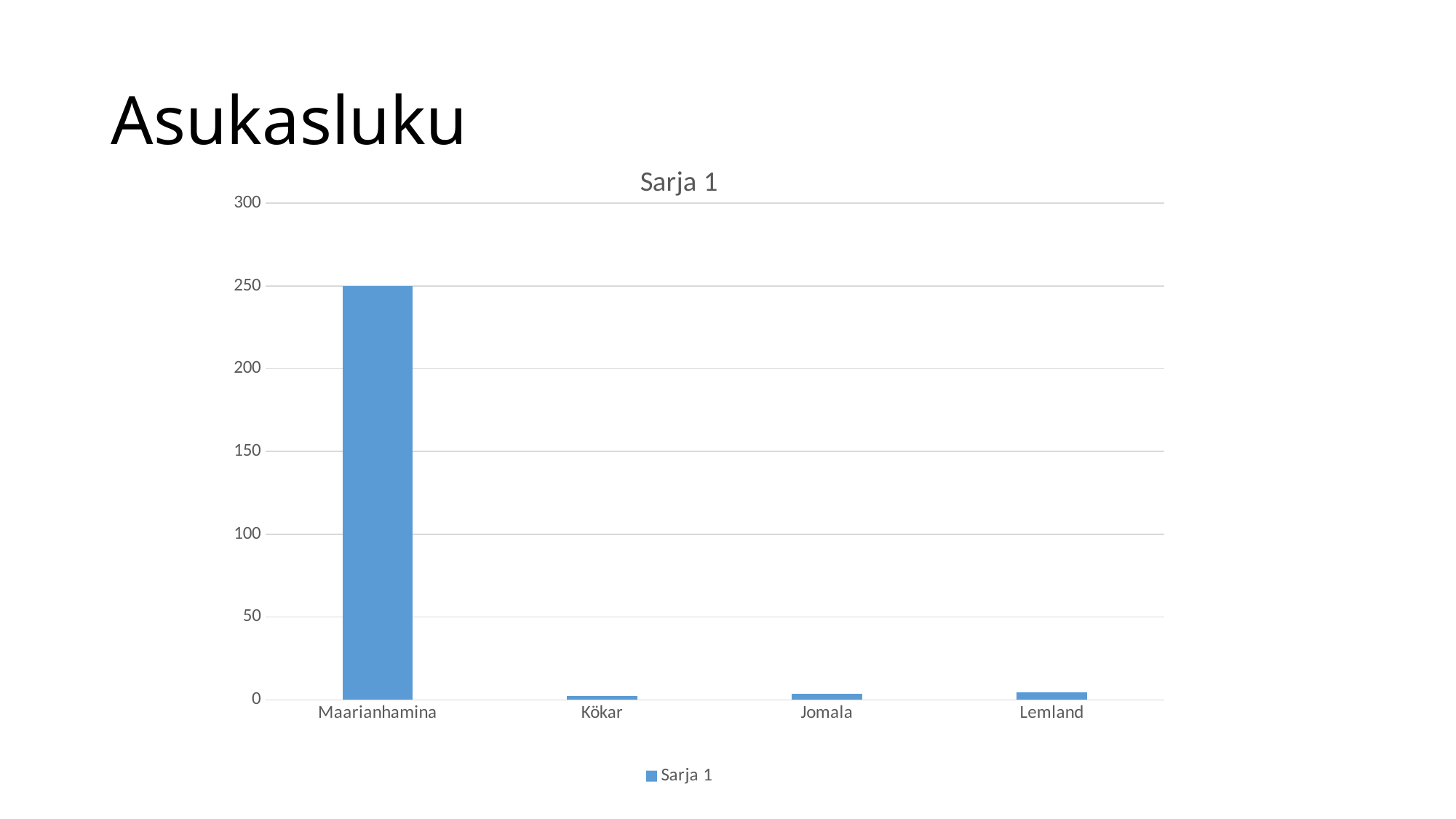
How many series does the chart legend list? 1 Is the value for Maarianhamina greater or less than 200? greater Which category has the highest value in the chart? Maarianhamina Which has the larger value, Maarianhamina or Lemland? Maarianhamina What is the title of the chart? Sarja 1 How many categories are shown on the x axis of the chart? 4 What kind of chart is shown on the slide? bar chart Is the value for Lemland greater or less than 50? less What is the title of the slide? Asukasluku Is the value for Jomala greater or less than 50? less What is the value for Maarianhamina in the chart? 250